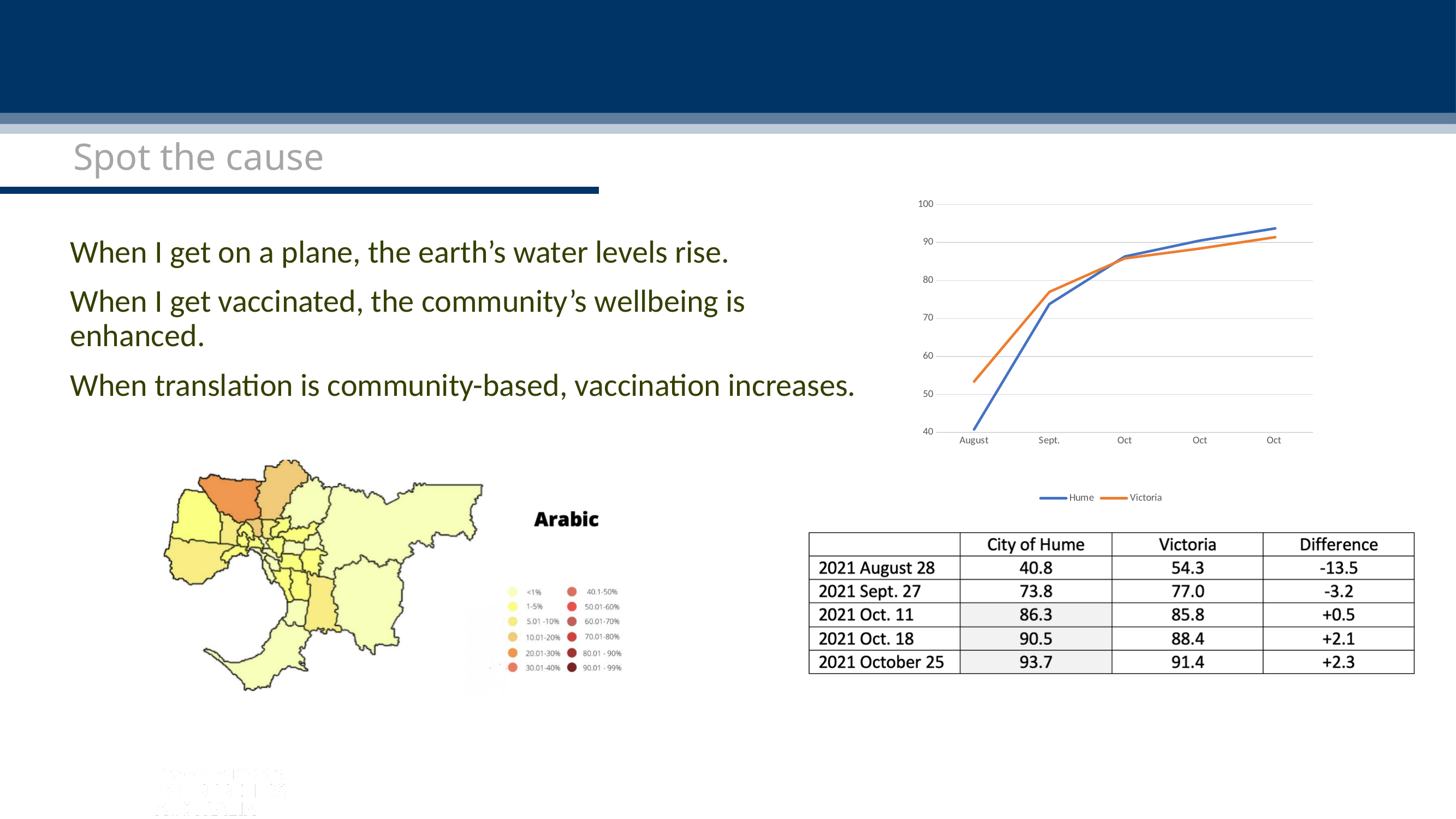
Do the values in the line chart rise or fall from August to the last Oct point? rise What kind of chart is shown on the right of the slide? line chart In the line chart, is the value for Victoria in Sept. greater or less than 80? less In the line chart, what colour is the Hume line? blue How many points are plotted along the x axis of the line chart? 5 In the line chart, is the value for Hume in August greater or less than 50? less In the line chart, at which x-axis category is the Hume value lowest? August In the line chart, which series has the larger value in August, Hume or Victoria? Victoria In the line chart, is the value for Victoria in August greater or less than 50? greater How many series does the legend of the line chart list? 2 In the line chart, which series has the larger value at the last (rightmost) Oct point, Hume or Victoria? Hume